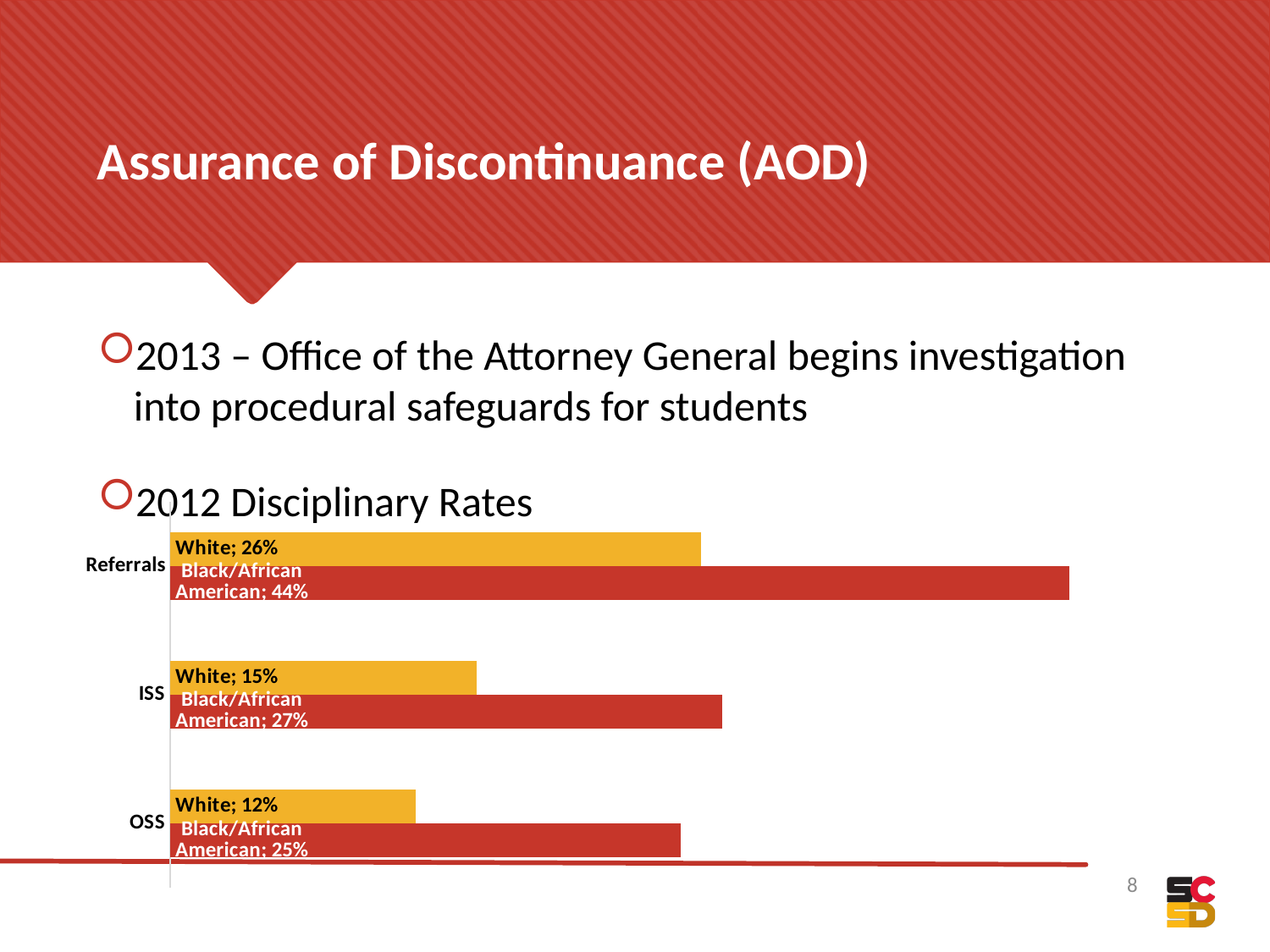
How many categories are shown on the chart? 3 Which is larger for OSS, the White rate or the Black/African American rate? Black/African American How many data series does the chart show? 2 What is the White rate for OSS? 12% What kind of chart is shown on the slide? Bar chart What is the White rate for ISS? 15% Which category has the highest Black/African American rate? Referrals What is the difference between the Black/African American and White rates for ISS? 12% What is the difference between the Black/African American and White rates for Referrals? 18% What is the Black/African American rate for Referrals? 44% What is the Black/African American rate for OSS? 25% Which category has the lowest White rate? OSS